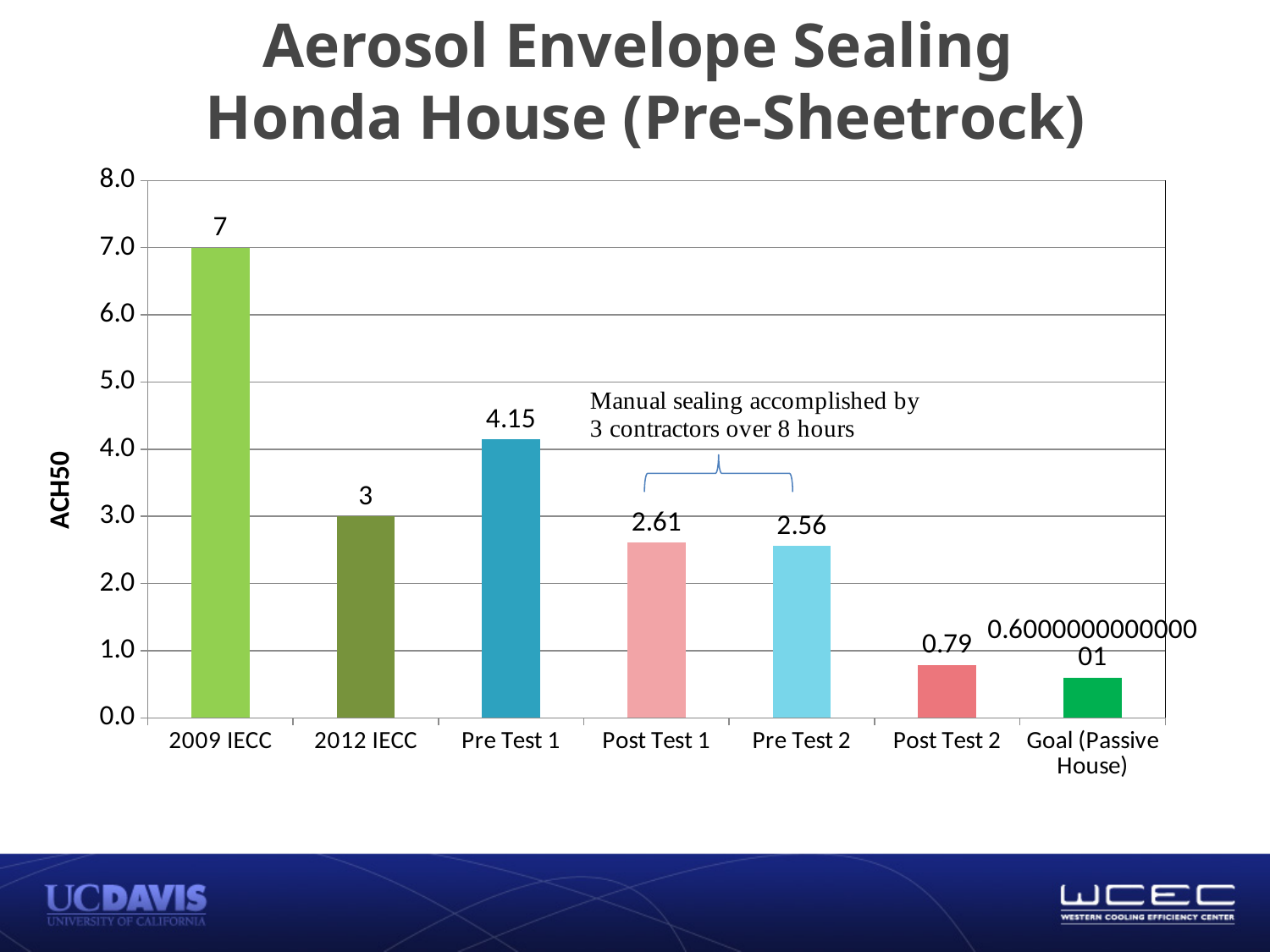
Which is larger, the value for Post Test 1 or the value for Pre Test 2? Post Test 1 What is the value shown for Pre Test 1? 4.15 What is the value shown for Post Test 2? 0.79 What is the ACH50 value for 2009 IECC? 7 Which category has the lowest value? Goal (Passive House) How many categories are shown on the x axis? 7 What is the label on the y axis? ACH50 What is the value shown for Post Test 1? 2.61 What is the difference between the 2009 IECC and 2012 IECC values? 4 What kind of chart is shown on the slide? Bar chart Which category has the highest value? 2009 IECC What is the difference between the Pre Test 1 and Post Test 1 values? 1.54